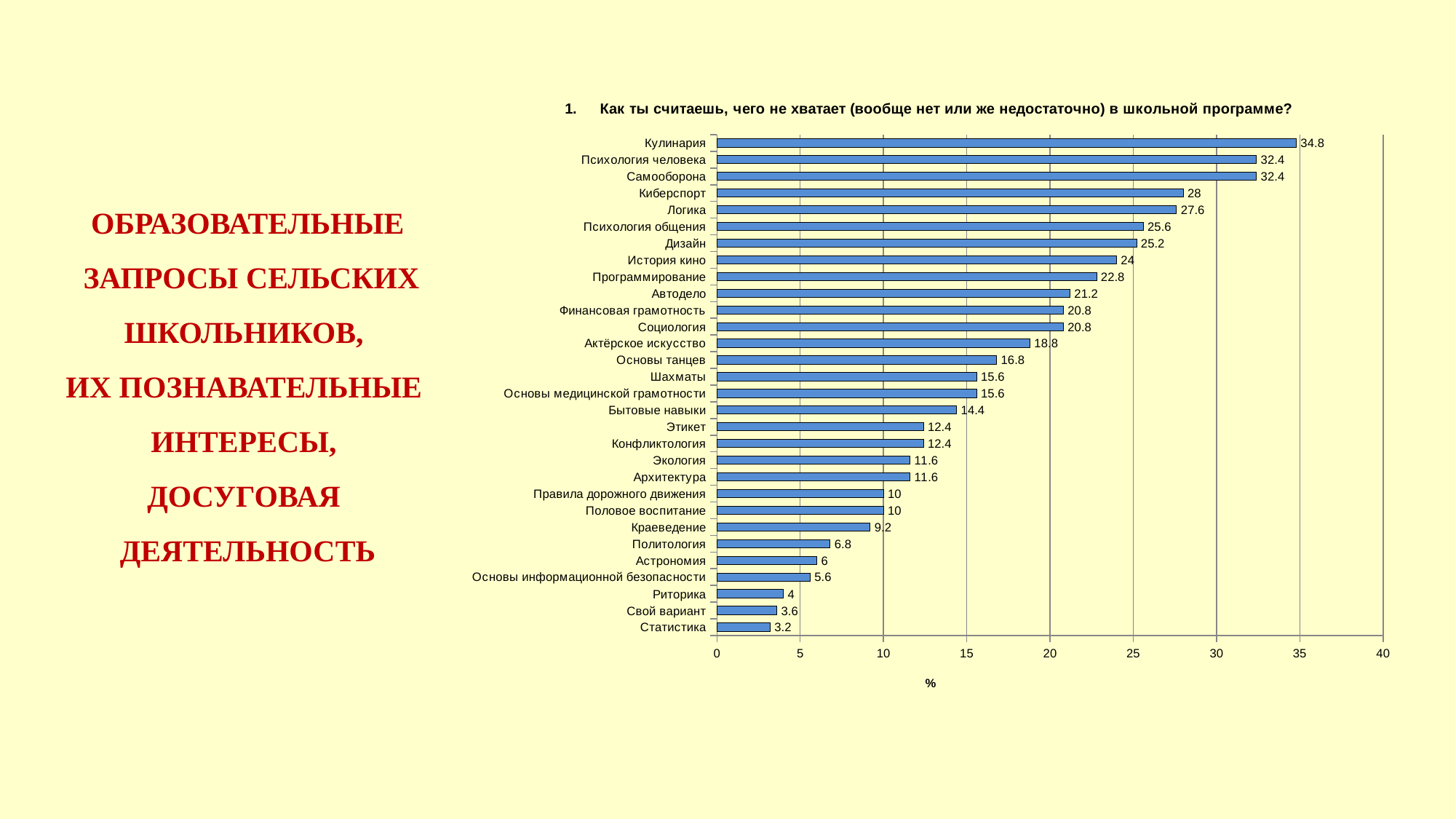
What is the value for Кулинария? 34.8 What is the value for Программирование? 22.8 Which category has the highest value? Кулинария What is the difference between the values for Кулинария and Киберспорт? 6.8 Is the value for История кино greater or less than 20? greater What kind of chart is shown on the slide? bar chart What is the value for Краеведение? 9.2 What is the label on the horizontal axis of the chart? % How many categories are shown in the chart? 30 Which is larger, the value for Логика or the value for Дизайн? Логика What is the value for Шахматы? 15.6 Which category has the lowest value? Статистика